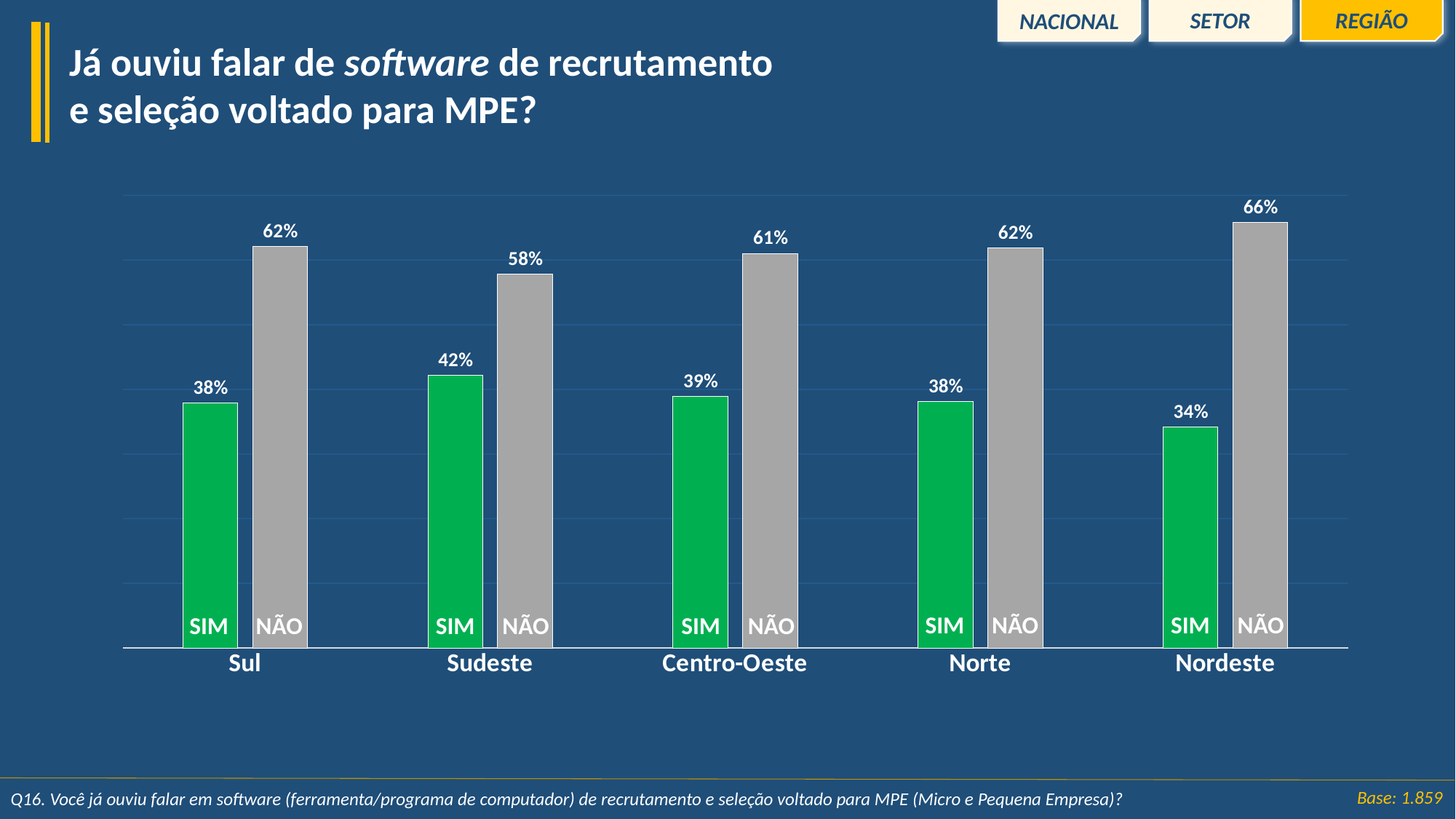
What is the SIM value for Centro-Oeste? 39% Which is larger, the SIM value for Sudeste or the SIM value for Norte? Sudeste Which region has the highest SIM value? Sudeste Which region has the lowest SIM value? Nordeste What is the NÃO value for Nordeste? 66% What is the difference between the NÃO and SIM values for Sul? 24% How many regions are shown on the x axis? 5 What is the SIM value for Sudeste? 42% What colour are the SIM bars? Green What kind of chart is shown on the slide? Bar chart How many series (SIM and NÃO) are plotted for each region? 2 Which region has the highest NÃO value? Nordeste